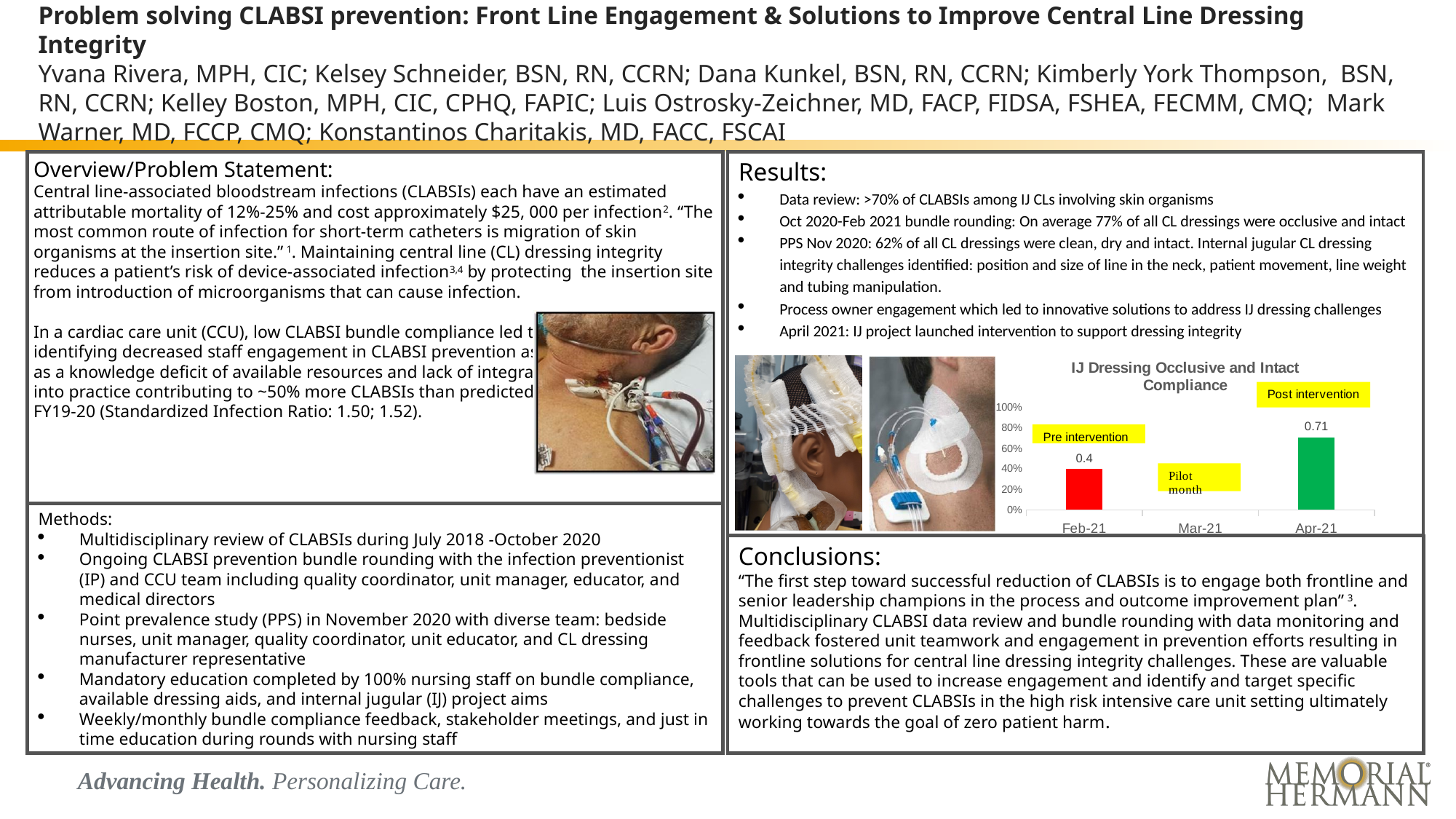
In the IJ Dressing Occlusive and Intact Compliance chart, is the value for Apr-21 greater or less than 60%? greater Which month has the highest labelled value in the IJ Dressing Occlusive and Intact Compliance chart? Apr-21 What kind of chart is the IJ Dressing Occlusive and Intact Compliance chart? bar chart In the IJ Dressing Occlusive and Intact Compliance chart, which is larger: the value for Feb-21 or the value for Apr-21? Apr-21 What is the value shown for Feb-21 in the IJ Dressing Occlusive and Intact Compliance chart? 0.4 How many months are listed on the x axis of the IJ Dressing Occlusive and Intact Compliance chart? 3 What colour is the Feb-21 bar in the IJ Dressing Occlusive and Intact Compliance chart? red What is the title of the chart on the slide? IJ Dressing Occlusive and Intact Compliance What is the difference between the Apr-21 and Feb-21 values in the IJ Dressing Occlusive and Intact Compliance chart? 0.31 Do the labelled values in the IJ Dressing Occlusive and Intact Compliance chart rise or fall from Feb-21 to Apr-21? rise In the IJ Dressing Occlusive and Intact Compliance chart, is the value for Feb-21 greater or less than 60%? less What is the value shown for Apr-21 in the IJ Dressing Occlusive and Intact Compliance chart? 0.71